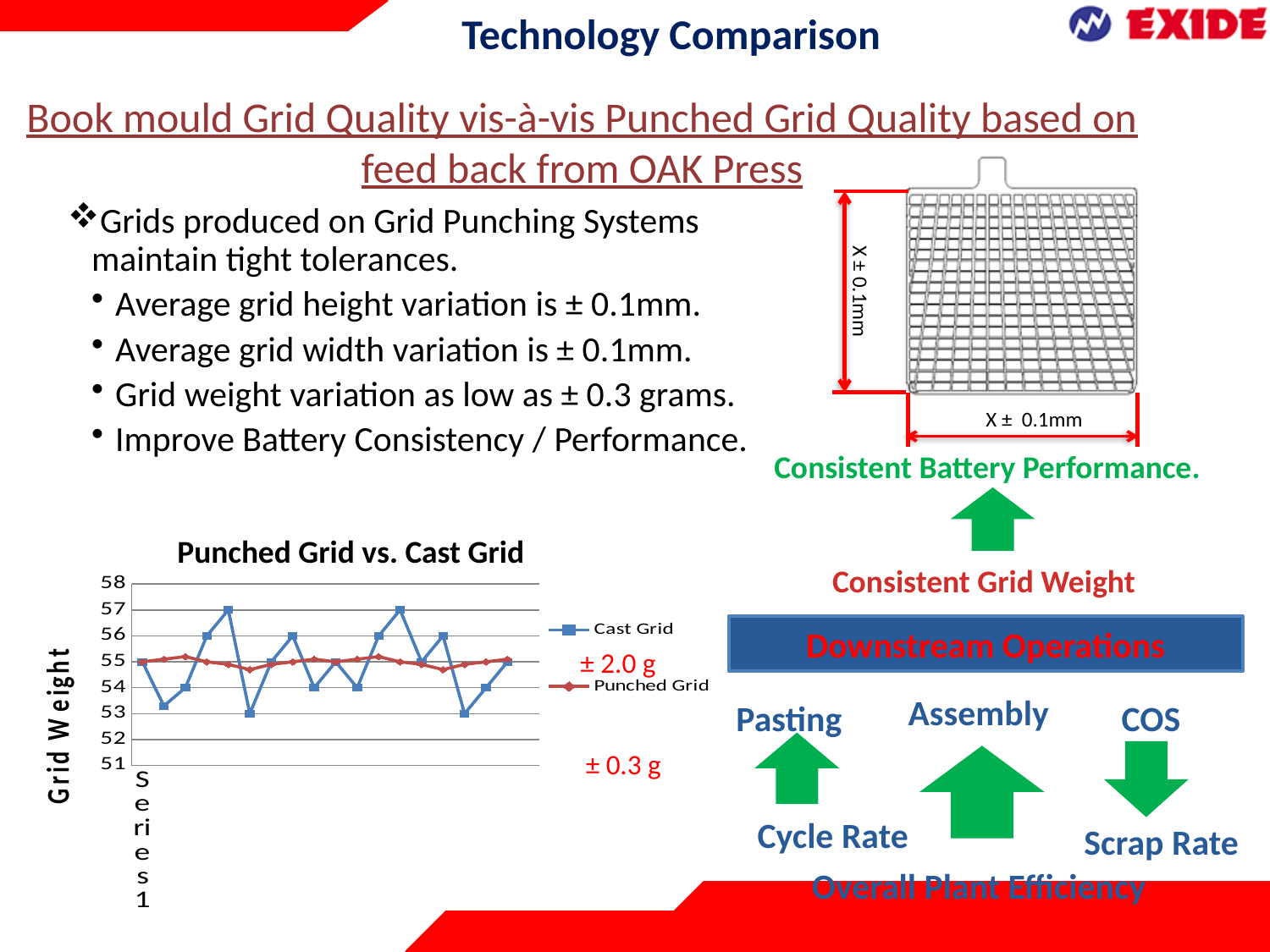
What are the two series named in the legend of the "Punched Grid vs. Cast Grid" chart? Cast Grid and Punched Grid How many series does the legend of the "Punched Grid vs. Cast Grid" chart list? 2 What is the highest value shown on the vertical axis of the "Punched Grid vs. Cast Grid" chart? 58 On the "Punched Grid vs. Cast Grid" chart, is the lowest Punched Grid value greater or less than 54? greater On the "Punched Grid vs. Cast Grid" chart, is the highest Cast Grid value greater or less than 56? greater On the "Punched Grid vs. Cast Grid" chart, is the highest Punched Grid value greater or less than 56? less What is the lowest value shown on the vertical axis of the "Punched Grid vs. Cast Grid" chart? 51 What type of chart is the "Punched Grid vs. Cast Grid" chart? line chart On the "Punched Grid vs. Cast Grid" chart, which series shows the larger variation in grid weight, Cast Grid or Punched Grid? Cast Grid What is the title of the vertical axis on the "Punched Grid vs. Cast Grid" chart? Grid Weight